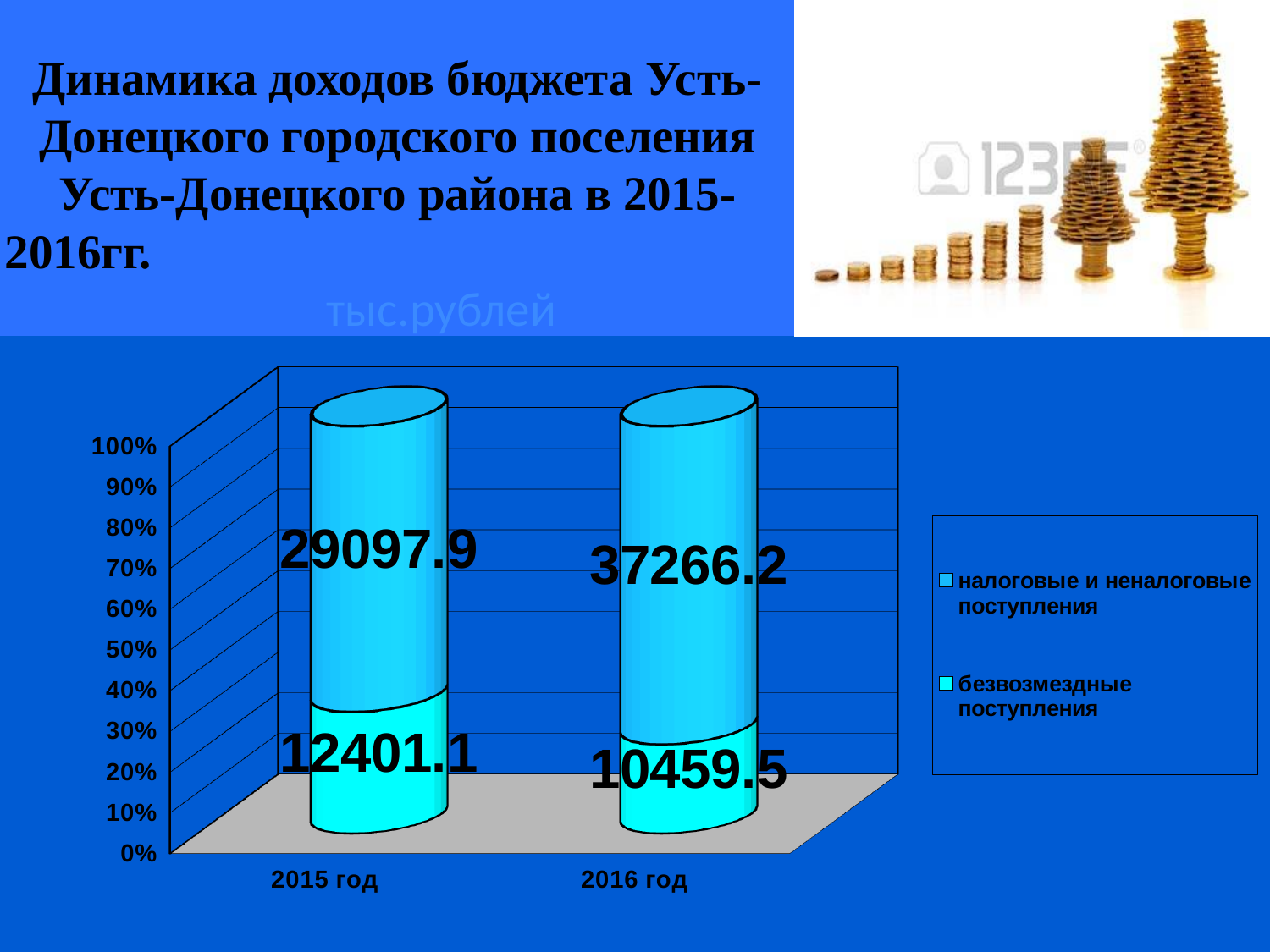
What is the value of безвозмездные поступления for 2016 год? 10459.5 What is the total of the two series for 2016 год? 47725.7 What type of chart is shown on the slide? bar chart What is the value of налоговые и неналоговые поступления for 2015 год? 29097.9 Which year has the larger value of безвозмездные поступления, 2015 год or 2016 год? 2015 год What is the difference between безвозмездные поступления in 2015 год and 2016 год? 1941.6 What is the value of налоговые и неналоговые поступления for 2016 год? 37266.2 How many years (categories) are shown on the x axis? 2 By how much did налоговые и неналоговые поступления increase from 2015 год to 2016 год? 8168.3 How many series does the legend list? 2 What is the value of безвозмездные поступления for 2015 год? 12401.1 Is the share of безвозмездные поступления in 2016 год greater or less than 30%? less